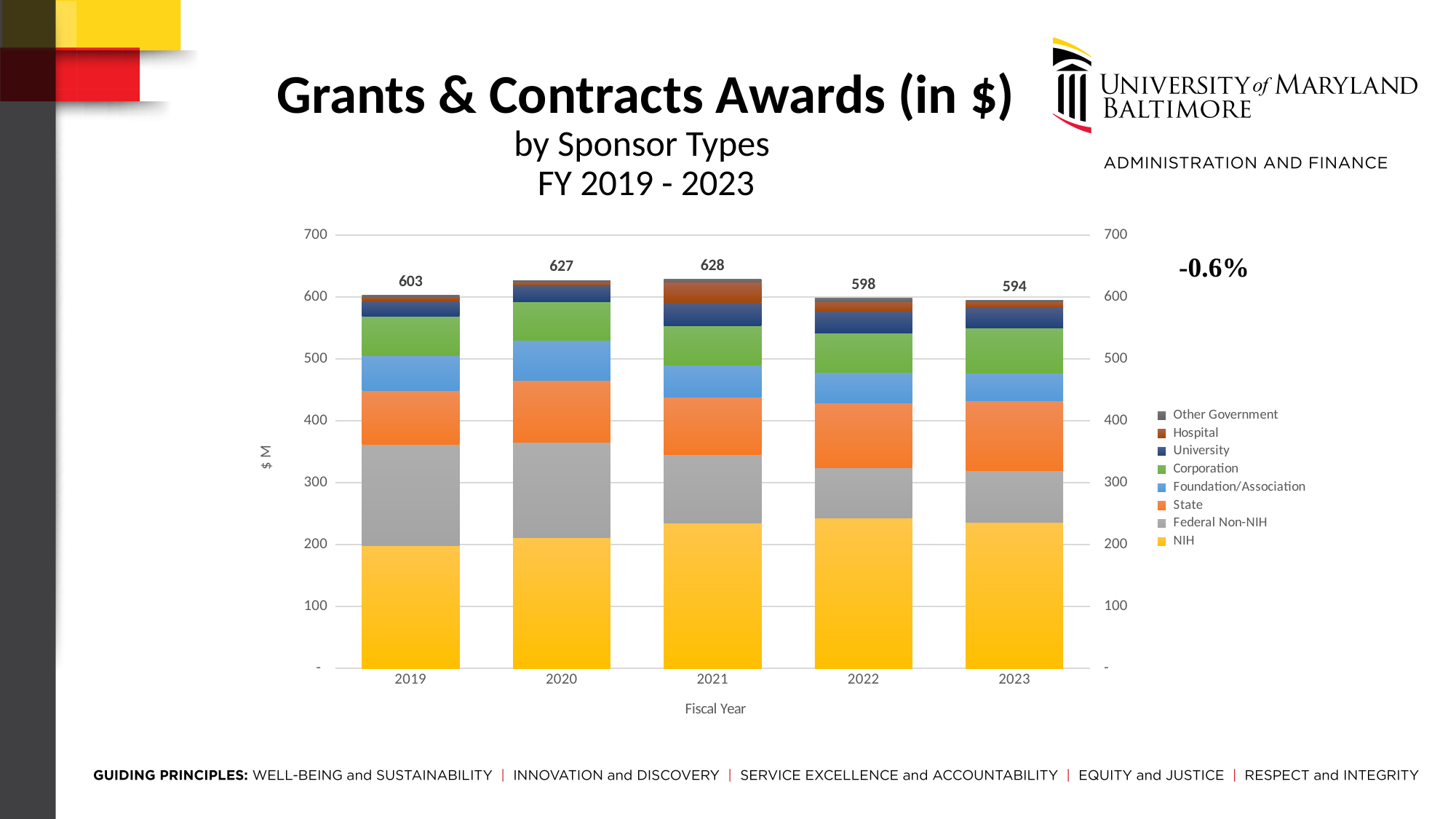
Which fiscal year has the lowest total awards value? 2023 How many fiscal years are shown on the x axis? 5 What is the difference between the total for 2020 and the total for 2019? 24 Do the total awards values rise or fall from 2021 to 2023? Fall How many sponsor types does the legend list? 8 Which fiscal year has a larger total, 2022 or 2020? 2020 What is the total value labeled on the bar for fiscal year 2021? 628 Which fiscal year has the highest total awards value? 2021 What kind of chart is shown on the slide? Stacked bar chart What is the total grants and contracts award value shown for fiscal year 2019? 603 Is the NIH value for 2022 greater or less than 200? greater What is the total value labeled on the bar for fiscal year 2023? 594